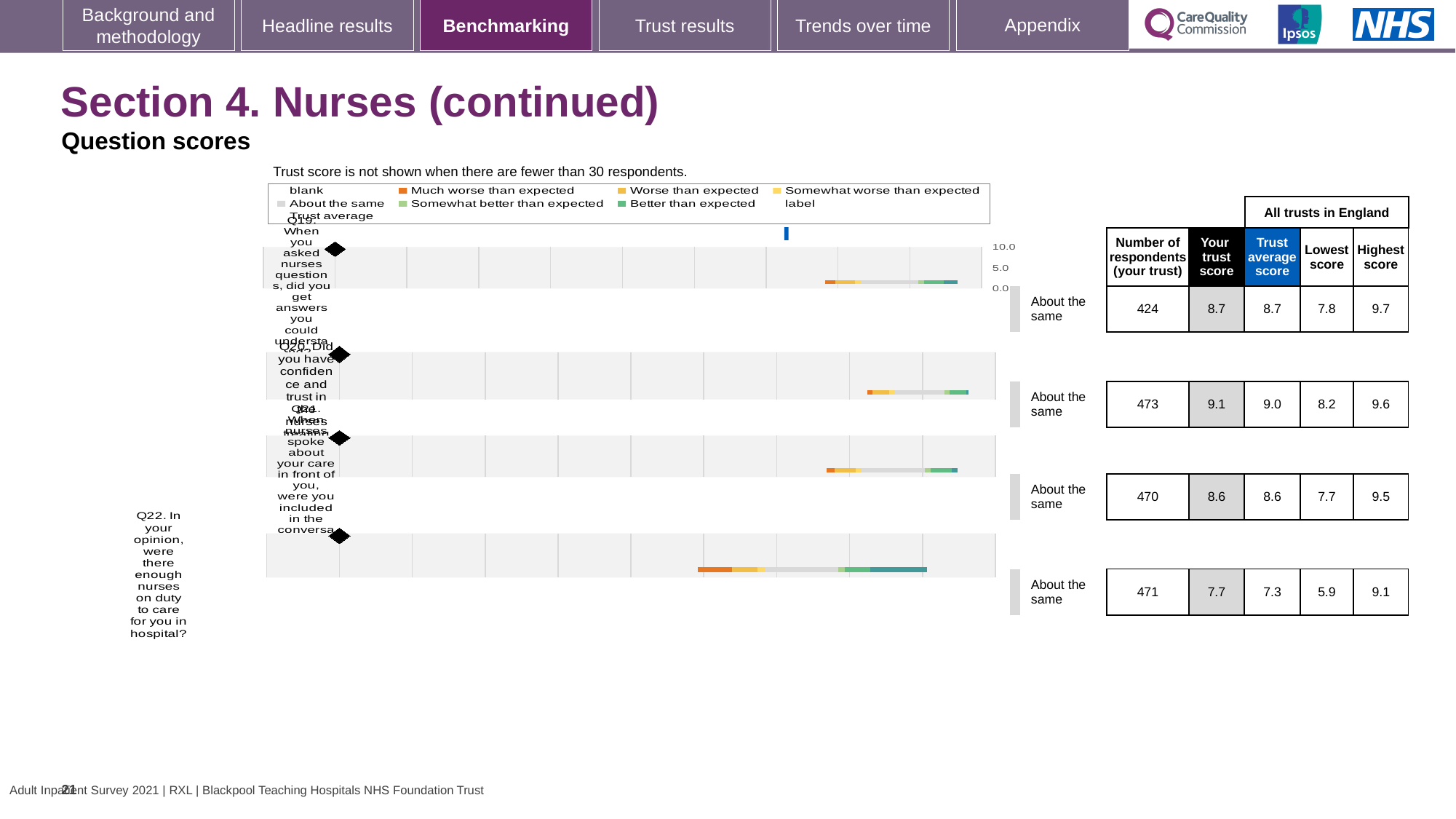
What benchmark category is shown next to Q19's bar? About the same What kind of chart is used to show the question scores on this slide? Bar chart What is the 'Your trust score' value for Q22 (were there enough nurses on duty to care for you in hospital)? 7.7 For Q22, what is the difference between the highest score (9.1) and the lowest score (5.9) across all trusts in England? 3.2 For Q20, how much higher is 'Your trust score' than the trust average score? 0.1 Which question has the highest 'Your trust score' on this slide? Q20 Which question has the lowest 'Your trust score' on this slide? Q22 What is the lowest score across all trusts in England for Q21? 7.7 How many questions are plotted on this slide? 4 How many respondents from the trust answered Q20 (did you have confidence and trust in the nurses treating you)? 473 What is the trust average score for all trusts in England for Q19? 8.7 For Q22, which is larger: 'Your trust score' or the trust average score? Your trust score